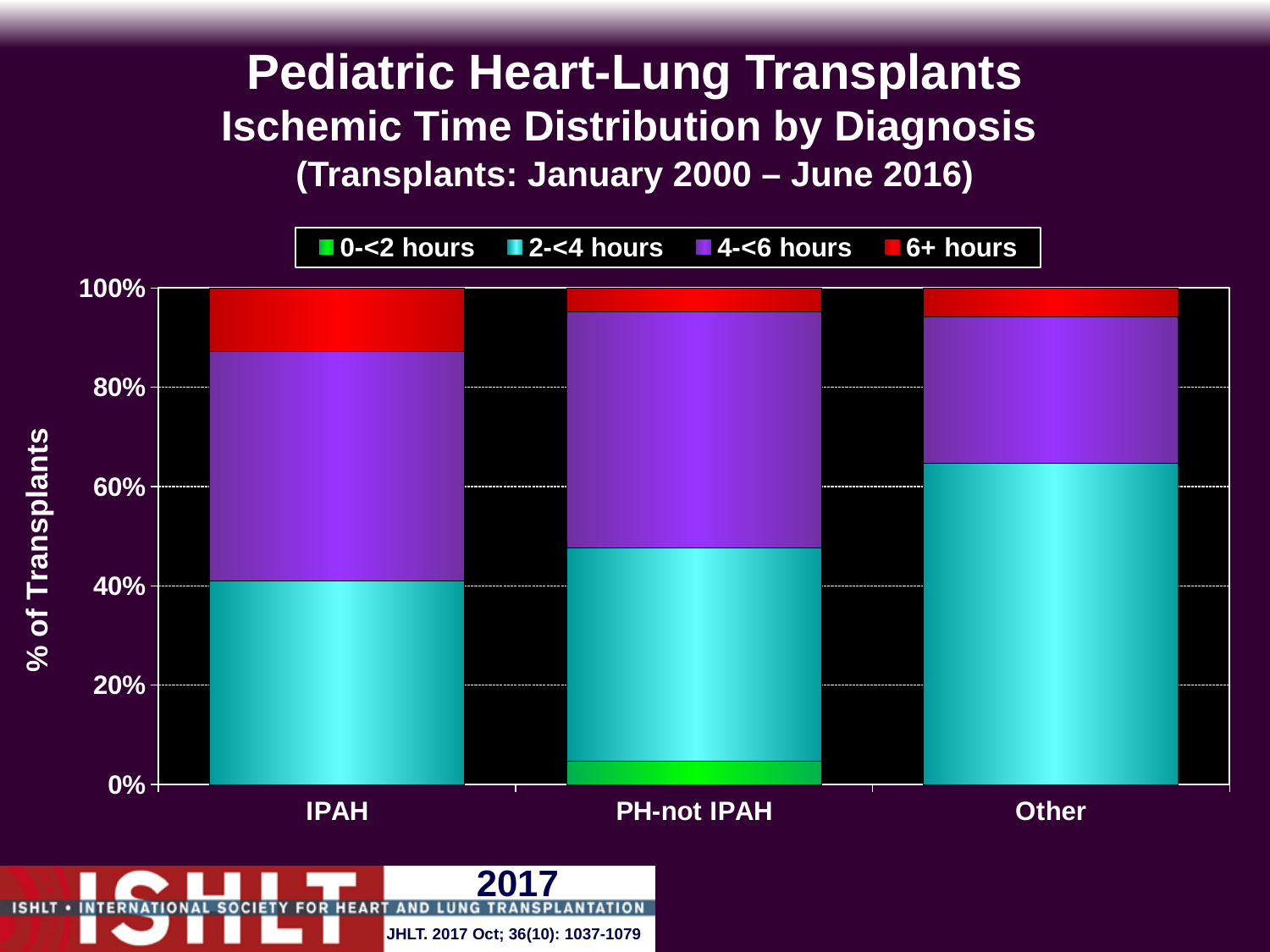
Which diagnosis category is the only one with a visible 0-<2 hours segment? PH-not IPAH What kind of chart is shown on the slide? Stacked bar chart Which diagnosis category has the largest 2-<4 hours segment? Other Is the 6+ hours segment larger for IPAH or for PH-not IPAH? IPAH Is the 2-<4 hours share for Other greater or less than 60%? greater What is the label of the y axis? % of Transplants Which diagnosis category has the largest 6+ hours segment? IPAH Is the 4-<6 hours segment larger for IPAH or for Other? IPAH What transplant date range is given in the chart title? January 2000 – June 2016 How many series does the legend list? 4 Is the 2-<4 hours share for IPAH greater or less than 60%? less How many diagnosis categories are shown on the x axis? 3